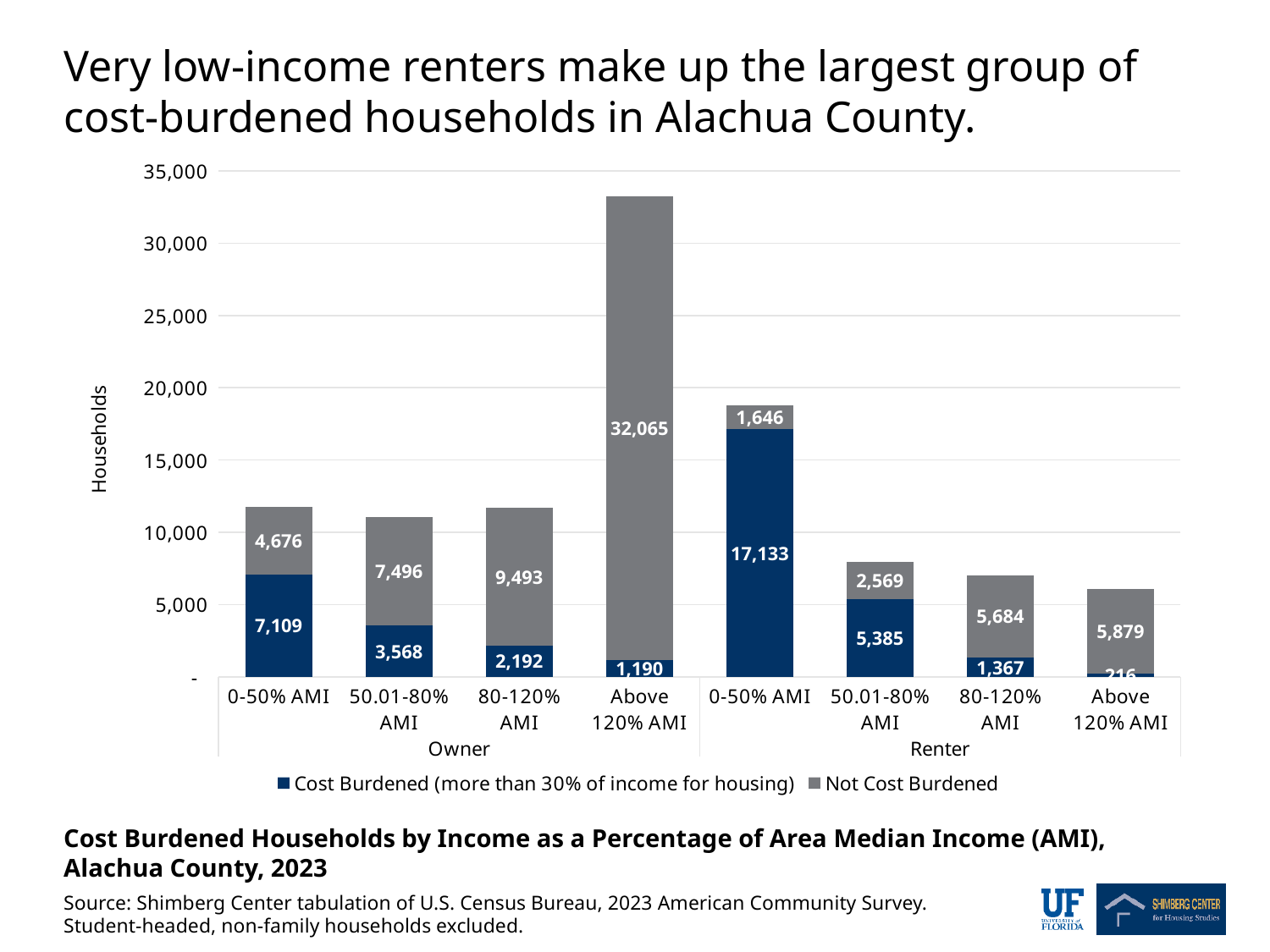
What kind of chart is shown on the slide? Stacked bar chart How many income categories are plotted along the x axis in total? 8 How many owner households above 120% AMI are not cost burdened? 32,065 How many cost-burdened renter households are in the 0-50% AMI group? 17,133 Which category has the lowest number of not-cost-burdened households? Renter 0-50% AMI How many cost-burdened owner households are in the 50.01-80% AMI group? 3,568 Is the total height of the Owner Above 120% AMI bar greater or less than 30,000? greater Which is larger: the number of cost-burdened owner households at 80-120% AMI or cost-burdened renter households at 80-120% AMI? Owner 80-120% AMI What is the difference between cost-burdened renter households at 0-50% AMI and cost-burdened owner households at 0-50% AMI? 10,024 How many series does the legend list? 2 Which category has the highest number of cost-burdened households? Renter 0-50% AMI What is the total number of households in the Owner 0-50% AMI bar? 11,785